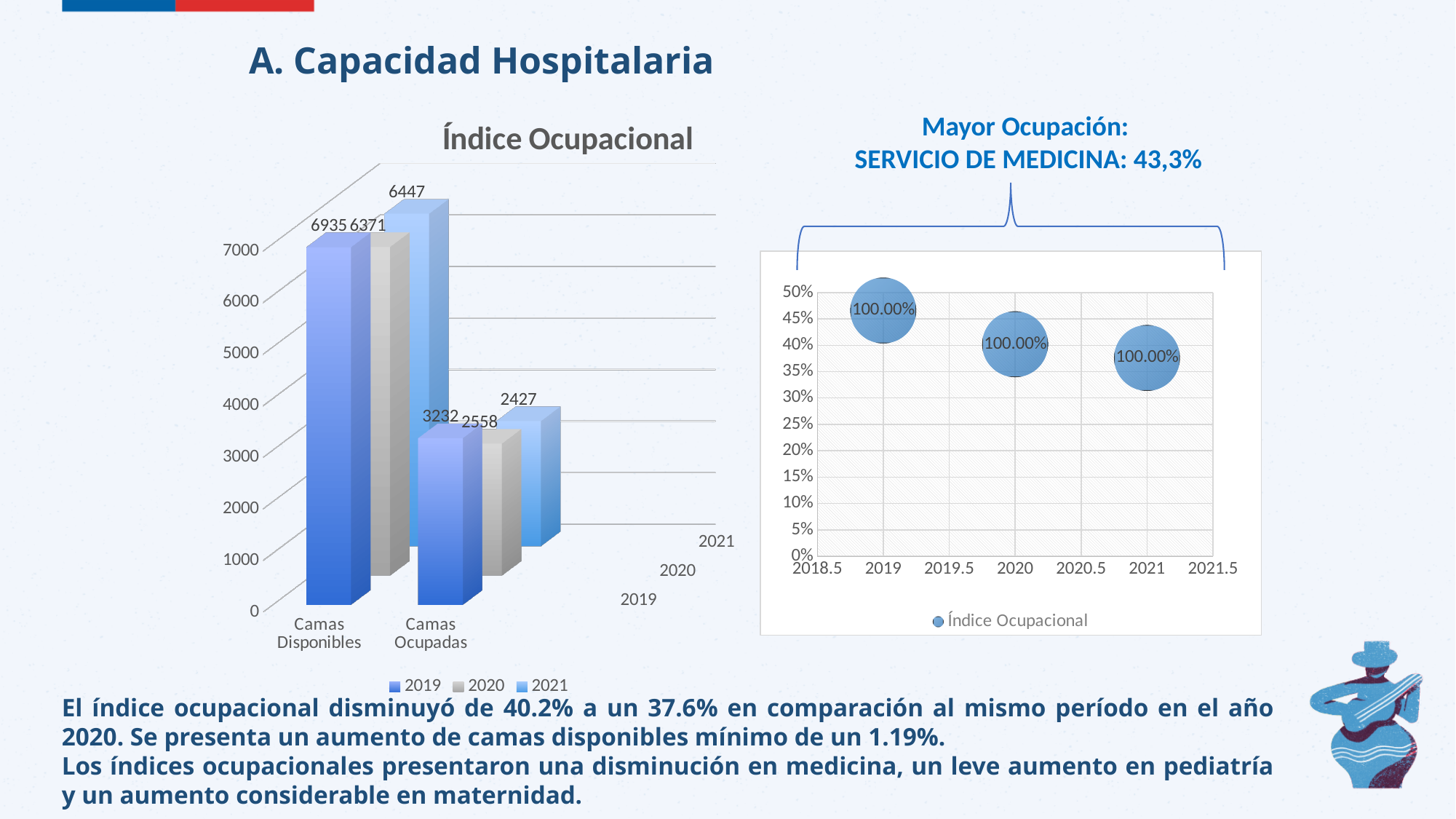
What kind of chart is the chart on the left of the slide? Bar chart In the bubble chart on the right, is the value for 2019 greater or less than 40%? greater In the bar chart titled 'Índice Ocupacional', what is the value for Camas Disponibles in 2020? 6371 In the bar chart titled 'Índice Ocupacional', which year has the highest value for Camas Ocupadas? 2019 In the bar chart titled 'Índice Ocupacional', what is the difference between Camas Disponibles and Camas Ocupadas in 2021? 4020 In the bar chart titled 'Índice Ocupacional', what is the difference between Camas Ocupadas in 2019 and in 2020? 674 In the bubble chart on the right, do the values rise or fall from 2019 to 2021? Fall How many series does the legend of the bar chart titled 'Índice Ocupacional' list? 3 In the bar chart titled 'Índice Ocupacional', what is the value for Camas Disponibles in 2019? 6935 In the bar chart titled 'Índice Ocupacional', what is the value for Camas Ocupadas in 2021? 2427 In the bar chart titled 'Índice Ocupacional', which year has the lowest value for Camas Disponibles? 2020 In the bar chart titled 'Índice Ocupacional', which is larger: Camas Disponibles in 2020 or Camas Disponibles in 2021? Camas Disponibles in 2021